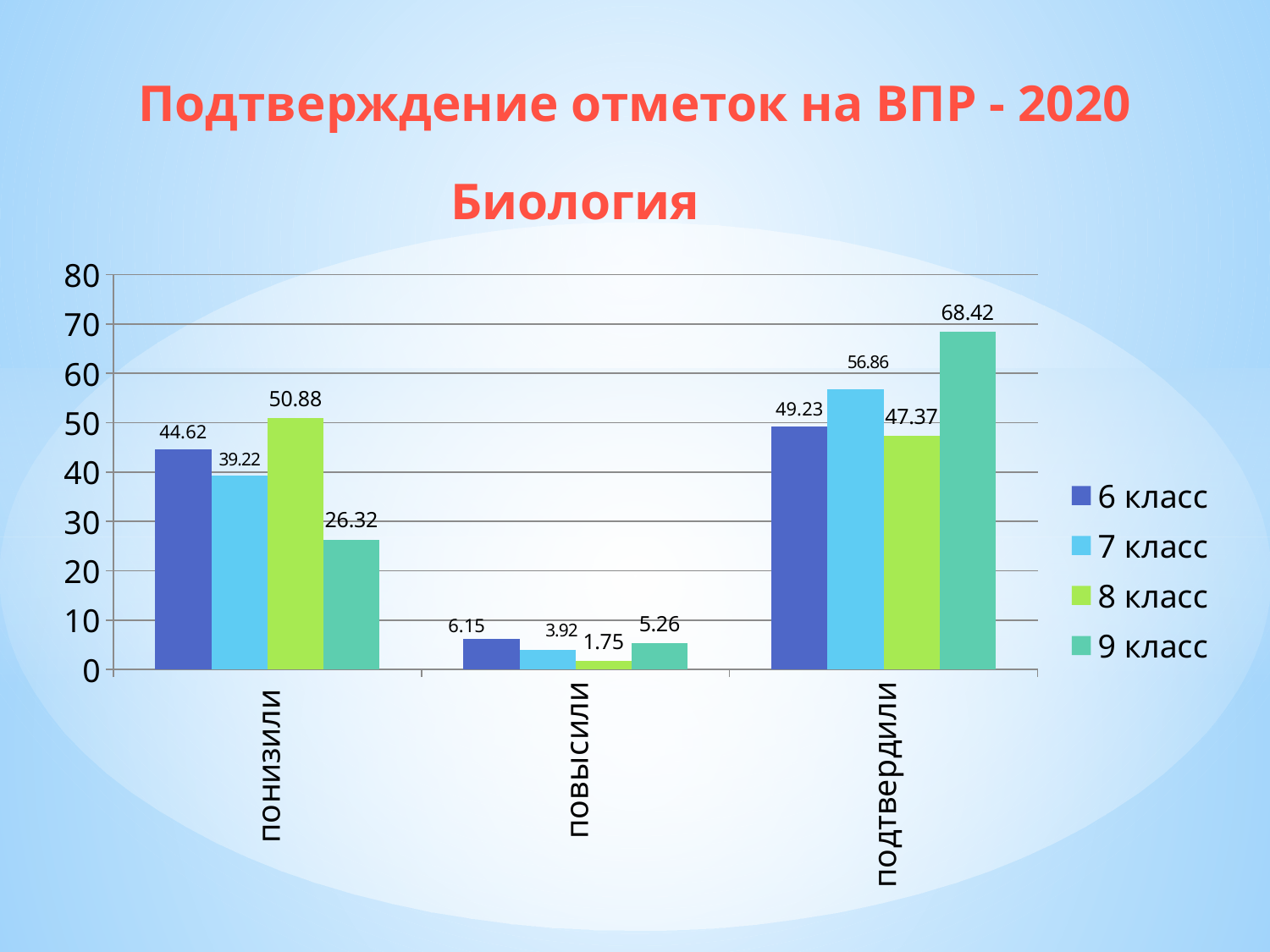
What is the value for 9 класс in the подтвердили category? 68.42 What is the title of the chart? Подтверждение отметок на ВПР - 2020 Биология What is the value for 7 класс in the понизили category? 39.22 What is the difference between the 9 класс and 6 класс values in the подтвердили category? 19.19 How many categories are shown on the x axis? 3 How many series does the legend list? 4 What kind of chart is shown on the slide? bar chart Is the value for 7 класс in the подтвердили category greater or less than 50? greater Which class has the highest value in the подтвердили category? 9 класс Which class has the lowest value in the понизили category? 9 класс Which is larger in the понизили category: the value for 6 класс or for 8 класс? 8 класс What is the value for 8 класс in the повысили category? 1.75